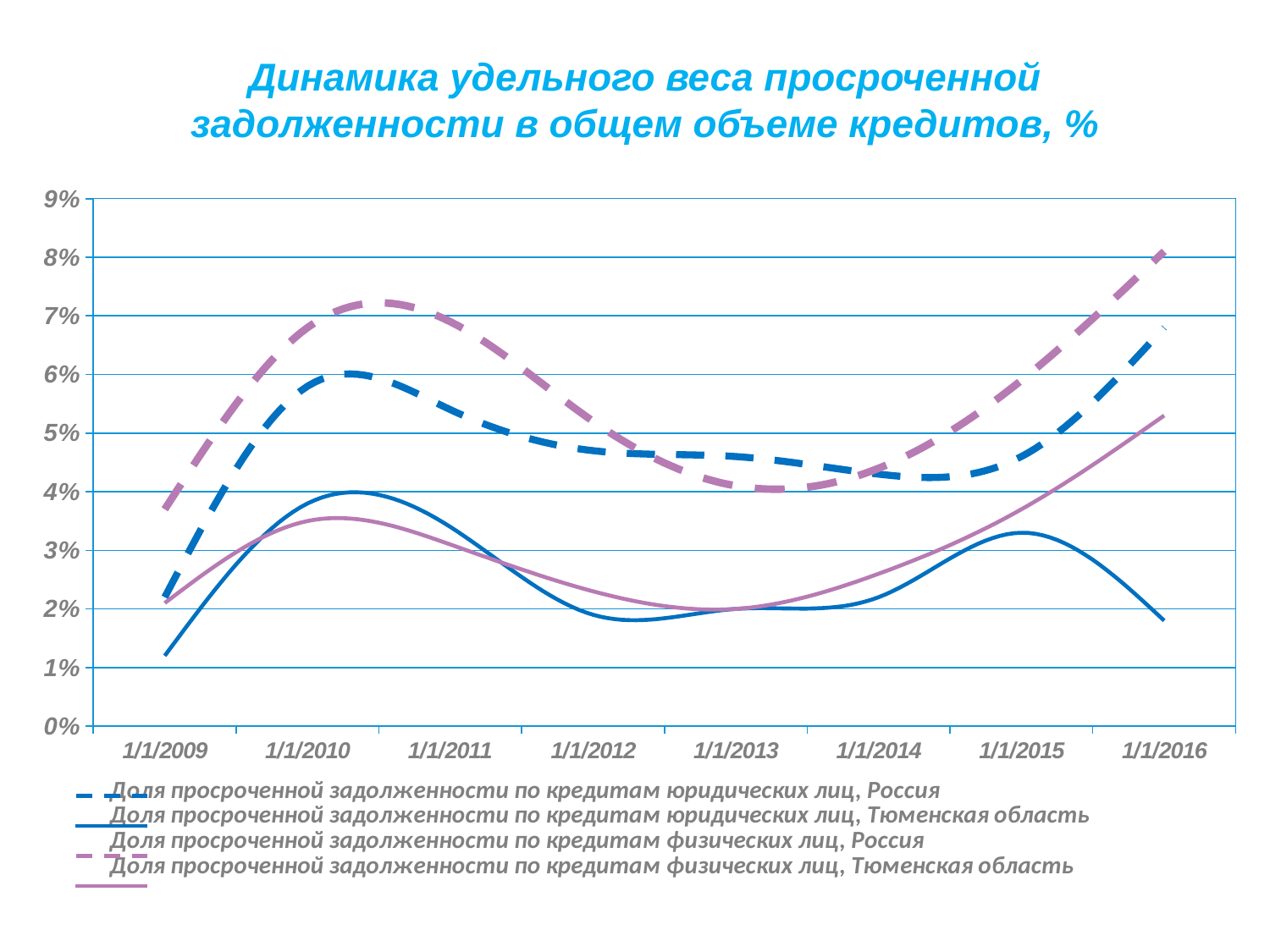
Is the value of the dashed blue line at 1/1/2010 greater or less than 5%? greater How many series does the legend list? 4 What is the highest value labelled on the y axis? 9% At 1/1/2016, which is higher: the dashed pink line or the solid blue line? the dashed pink line What kind of chart is shown on the slide? line chart Is the value of the solid blue line at 1/1/2009 greater or less than 2%? less Which line reaches the highest value anywhere on the chart? the dashed pink line Does the solid blue line rise or fall between 1/1/2015 and 1/1/2016? fall Is the value of the dashed pink line at 1/1/2016 greater or less than 7%? greater Does the solid pink line rise or fall between 1/1/2013 and 1/1/2016? rise How many dates are labelled on the x axis? 8